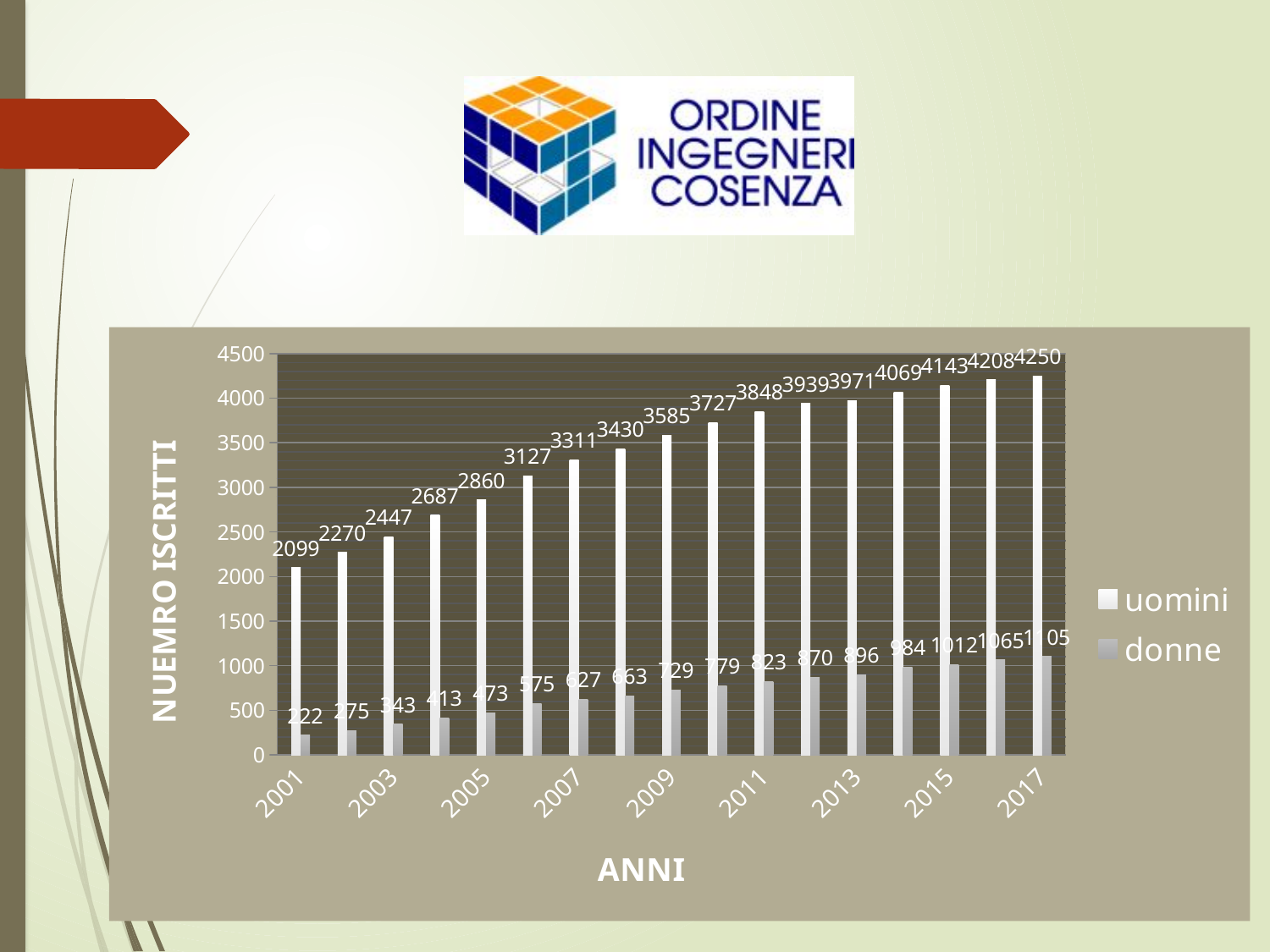
Do the values for donne rise or fall from 2001 to 2017? rise What is the value for donne in 2005? 473 What is the value for uomini in 2001? 2099 How many series does the legend list? 2 What is the label of the vertical axis? NUEMRO ISCRITTI What is the difference between the uomini and donne values in 2017? 3145 What kind of chart is shown on the slide? bar chart Which is larger in 2013, the value for uomini or the value for donne? uomini In which year is the value for uomini highest? 2017 In which year is the value for donne lowest? 2001 What is the value for donne in 2017? 1105 What is the value for uomini in 2009? 3585